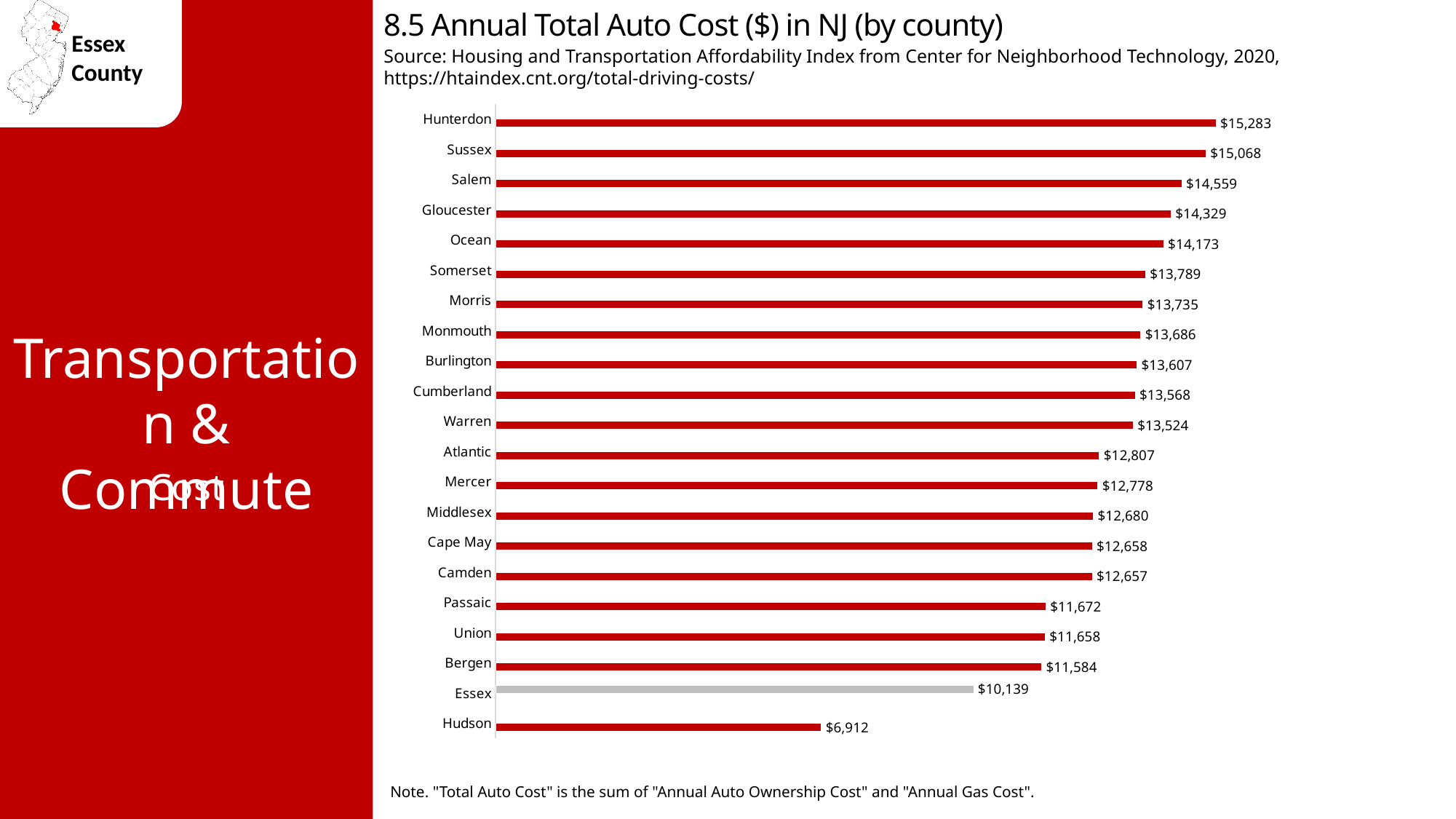
What is the annual total auto cost for Essex County? $10,139 How many counties are shown in the chart? 21 What is the annual total auto cost for Hunterdon County? $15,283 Which county has the lowest annual total auto cost? Hudson Which county has a higher annual total auto cost, Passaic or Bergen? Passaic What is the annual total auto cost for Bergen County? $11,584 What is the difference in annual total auto cost between Hunterdon and Essex? $5,144 What type of chart is shown on the slide? Bar chart What is the difference in annual total auto cost between Essex and Hudson? $3,227 Which county has a higher annual total auto cost, Sussex or Salem? Sussex Which county's bar is shown in grey instead of red? Essex Which county has the highest annual total auto cost? Hunterdon